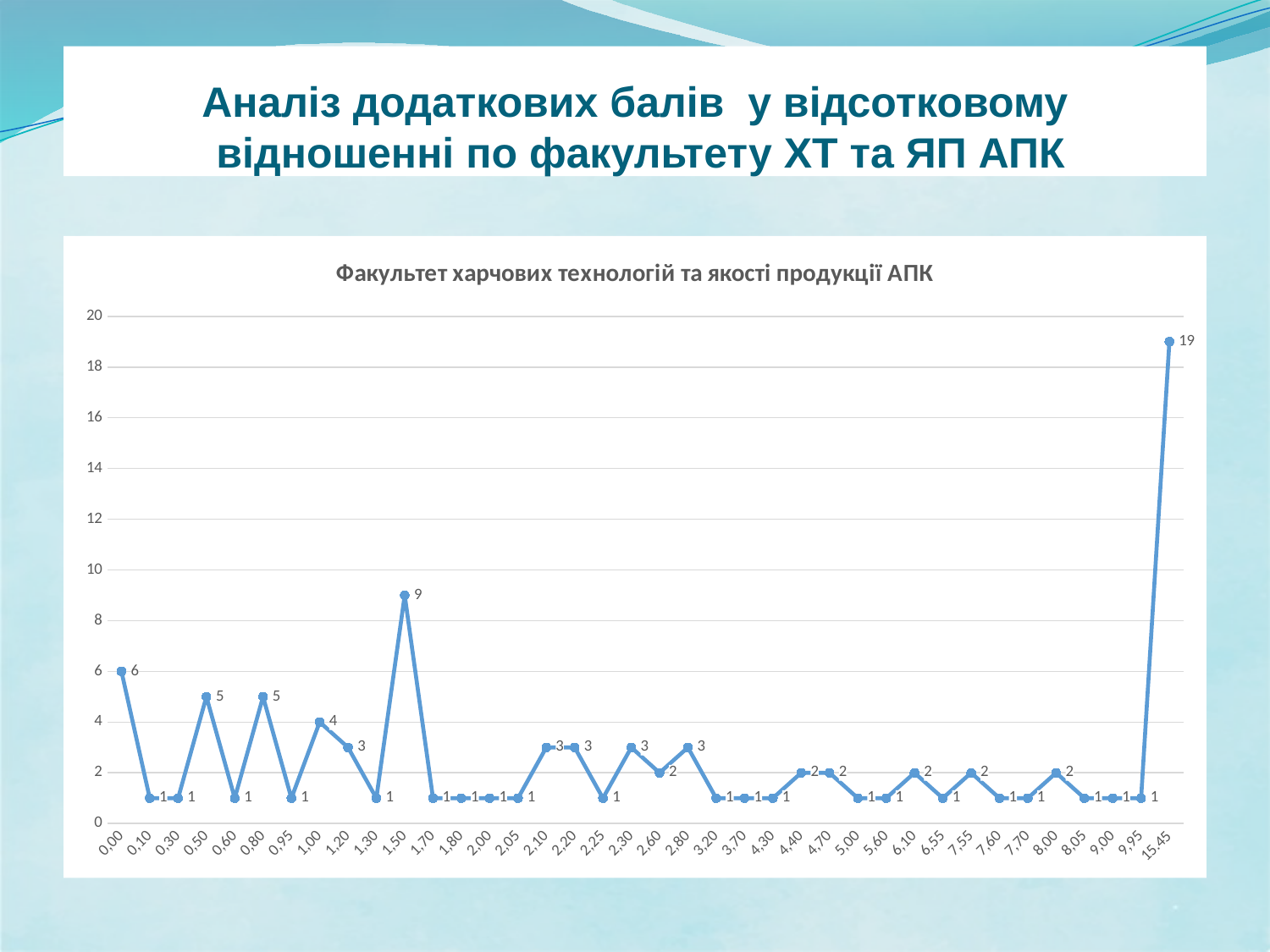
What is the value at category 0,00? 6 Which category has the highest value? 15,45 What is the value at category 1,00? 4 What is the title of the chart? Факультет харчових технологій та якості продукції АПК How many data points are plotted on the chart? 38 Is the value at 15,45 greater or less than 18? greater What is the difference between the values at 15,45 and 1,50? 10 What is the value at category 15,45? 19 What type of chart is shown on the slide? line chart What is the value at category 1,50? 9 What is the difference between the values at 0,00 and 0,50? 1 Which is larger, the value at 0,50 or the value at 1,20? 0,50